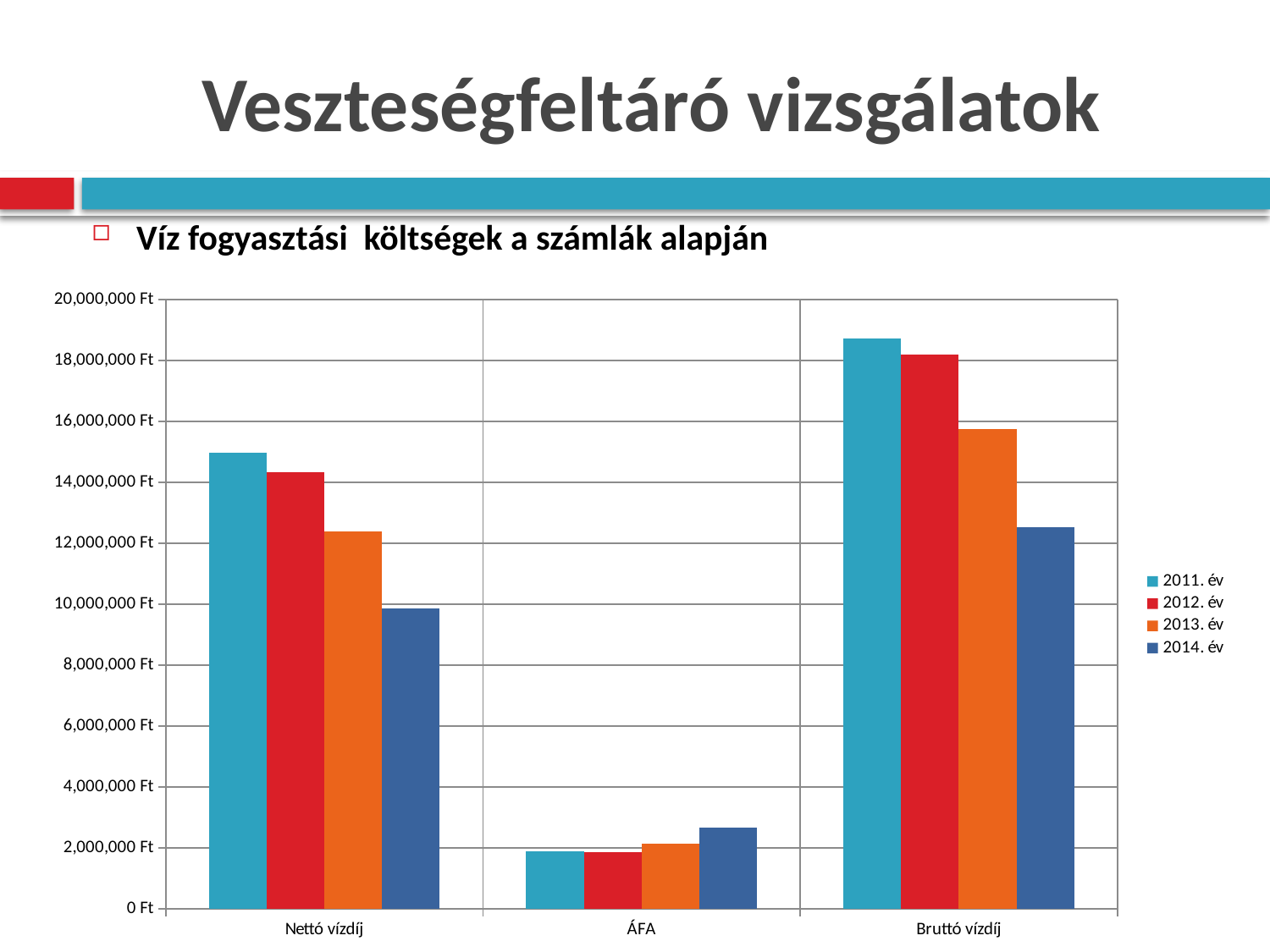
Is the value for ÁFA in 2014. év greater or less than 2,000,000 Ft? greater Do the Nettó vízdíj values rise or fall from 2011. év to 2014. év? fall What kind of chart is shown on the slide? bar chart What is the text of the bullet point above the chart? Víz fogyasztási költségek a számlák alapján Which category has the lowest values in the chart? ÁFA Which is larger: Nettó vízdíj in 2011. év or Bruttó vízdíj in 2014. év? Nettó vízdíj in 2011. év Which year has the highest bar for ÁFA? 2014. év Is the value for Bruttó vízdíj in 2011. év greater or less than 18,000,000 Ft? greater Is the value for Nettó vízdíj in 2011. év greater or less than 14,000,000 Ft? greater Which year has the highest bar for Bruttó vízdíj? 2011. év How many series does the legend list? 4 How many categories are shown on the x axis of the chart? 3